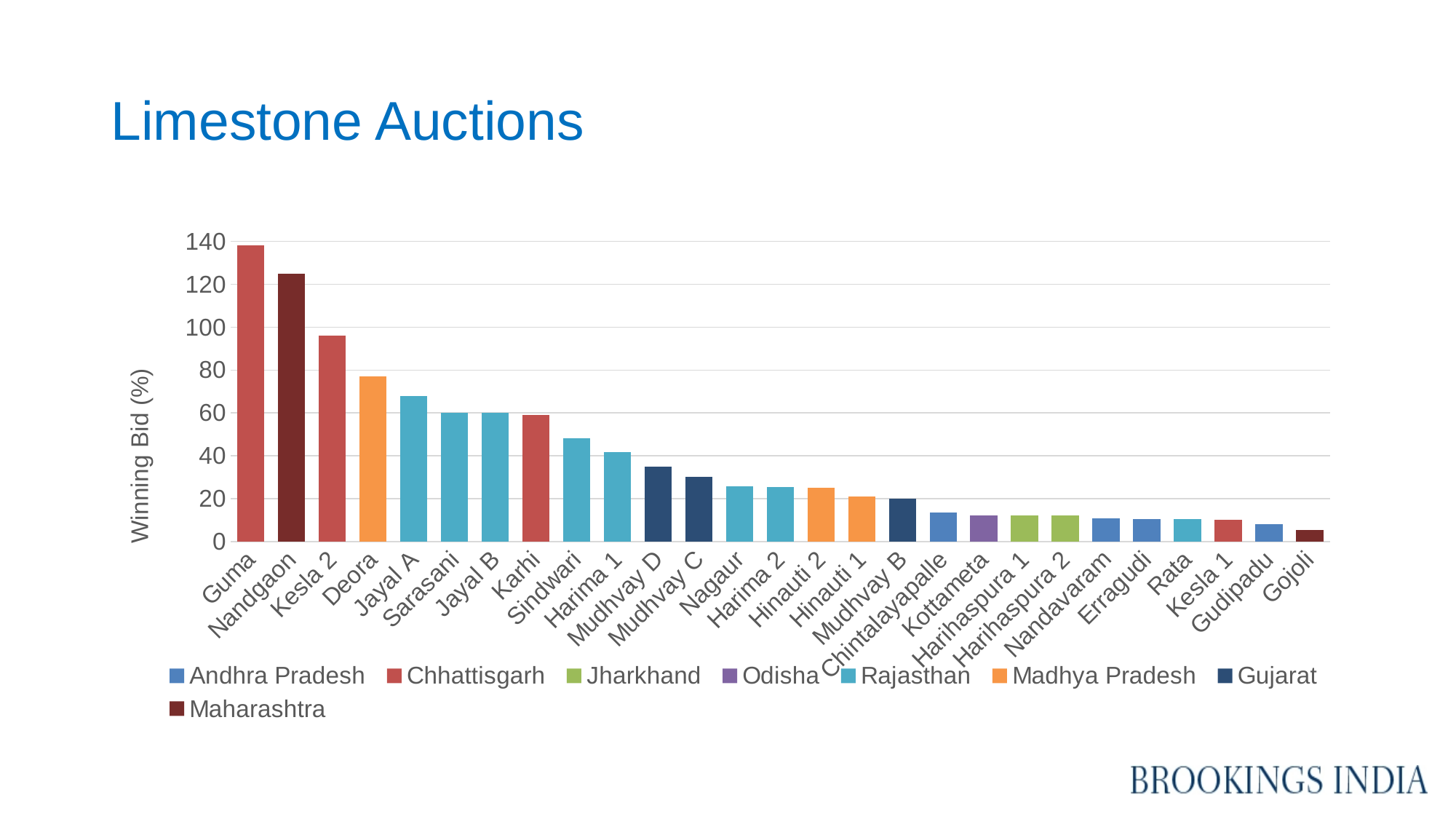
Is the winning bid for Guma greater or less than 120? greater How many mines (bars) are shown on the x axis? 27 Which has the larger winning bid, Guma or Nandgaon? Guma Is the winning bid for Gojoli greater or less than 20? less Is the winning bid for Mudhvay D greater or less than 40? less How many states does the legend list? 8 What kind of chart is shown on the slide? Bar chart What is the label on the vertical axis? Winning Bid (%) Do the winning bids rise or fall moving from left to right along the x axis? Fall Which mine has the highest winning bid? Guma Which mine has the lowest winning bid? Gojoli